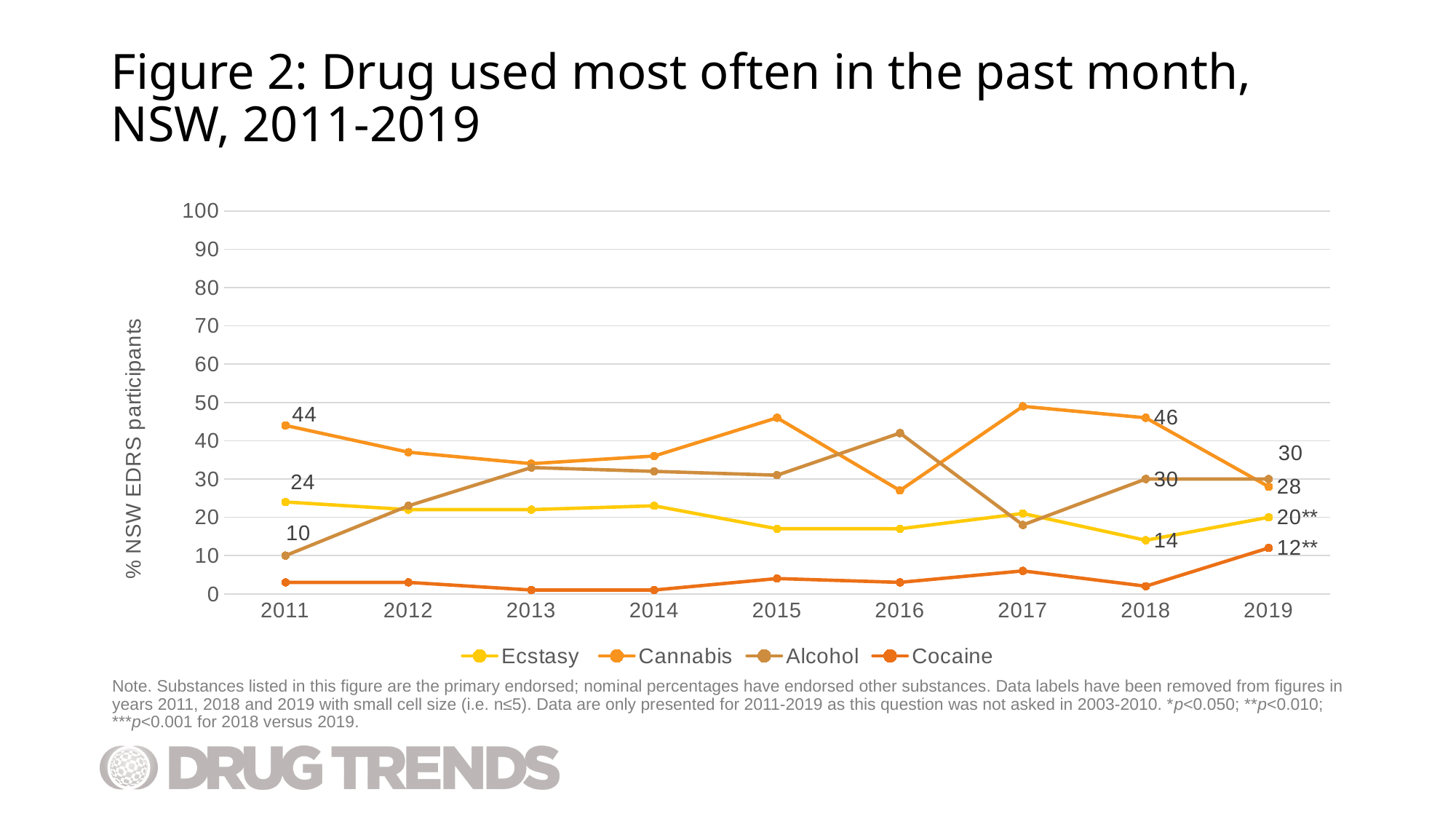
What is the value for Cocaine in 2019? 12** What kind of chart is shown on the slide? line chart In 2019, which is larger: the value for Alcohol or the value for Cannabis? Alcohol What is the value for Cannabis in 2011? 44 What is the difference between the Cannabis values in 2011 and 2019? 16 Is the value for Cannabis in 2017 greater or less than 40? greater How many years are shown on the x axis? 9 What is the value for Alcohol in 2019? 30 What is the value for Ecstasy in 2018? 14 How many series does the legend list? 4 Which series has the lowest value in 2019? Cocaine Which series has the highest value in 2011? Cannabis